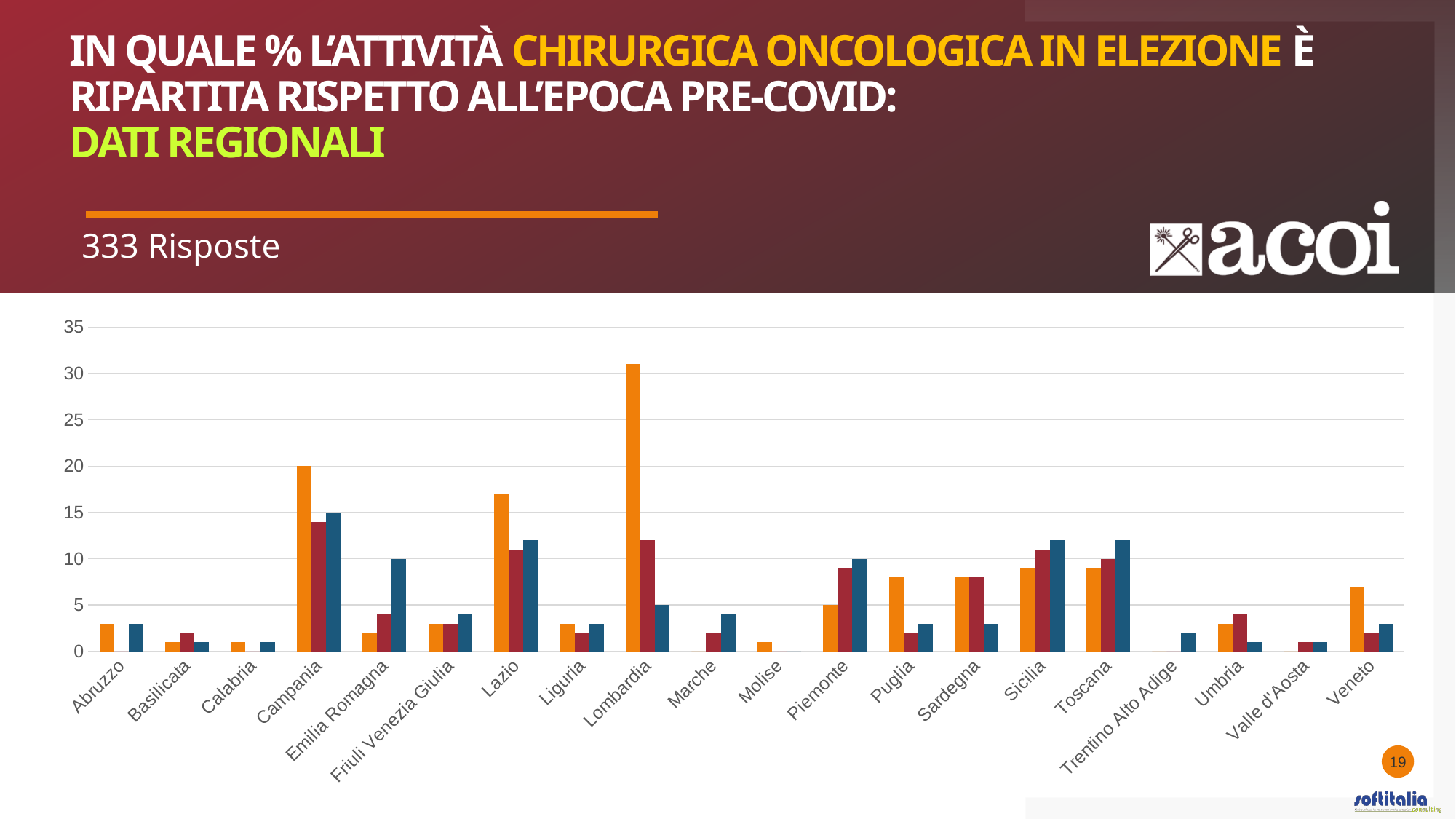
What is the value of the blue bar for Campania? 15 Which is larger, the orange bar for Campania or the orange bar for Lazio? Campania What is the value of the orange bar for Campania? 20 Which region has the tallest bar in the chart? Lombardia What is the value of the blue bar for Emilia Romagna? 10 Is the orange bar for Veneto greater or less than 10? less How many regions (categories) are shown on the x axis of the chart? 20 How many responses does the slide say the chart is based on? 333 Risposte Is the orange bar for Lombardia greater or less than 25? greater Which is larger, the blue bar for Lombardia or the blue bar for Lazio? Lazio What kind of chart is shown on the slide? bar chart Is the orange bar for Lazio greater or less than 15? greater